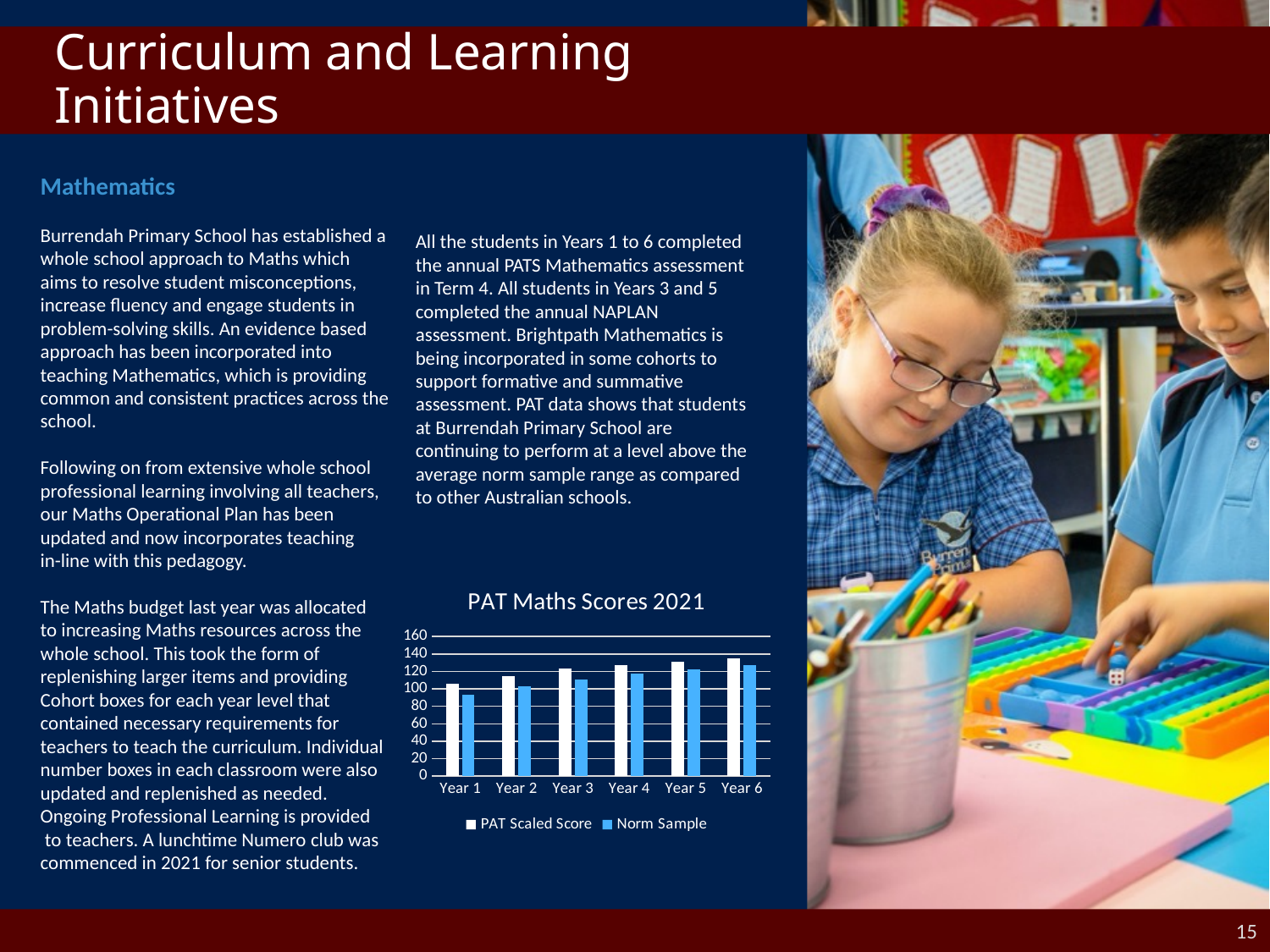
Is the PAT Scaled Score for Year 6 greater or less than 120? greater How many year-level categories are shown on the x axis of the chart? 6 Is the Norm Sample value for Year 5 greater or less than 100? greater Which year level has the highest PAT Scaled Score in the chart? Year 6 Which series in the chart is shown with blue bars? Norm Sample What kind of chart is shown on the slide? bar chart For Year 1, which is larger: the PAT Scaled Score or the Norm Sample? PAT Scaled Score Is the Norm Sample value for Year 1 greater or less than 100? less Do the PAT Scaled Score values rise or fall from Year 1 to Year 6? rise How many series does the chart's legend list? 2 What is the title of the chart on the slide? PAT Maths Scores 2021 Which year level has the lowest Norm Sample value in the chart? Year 1